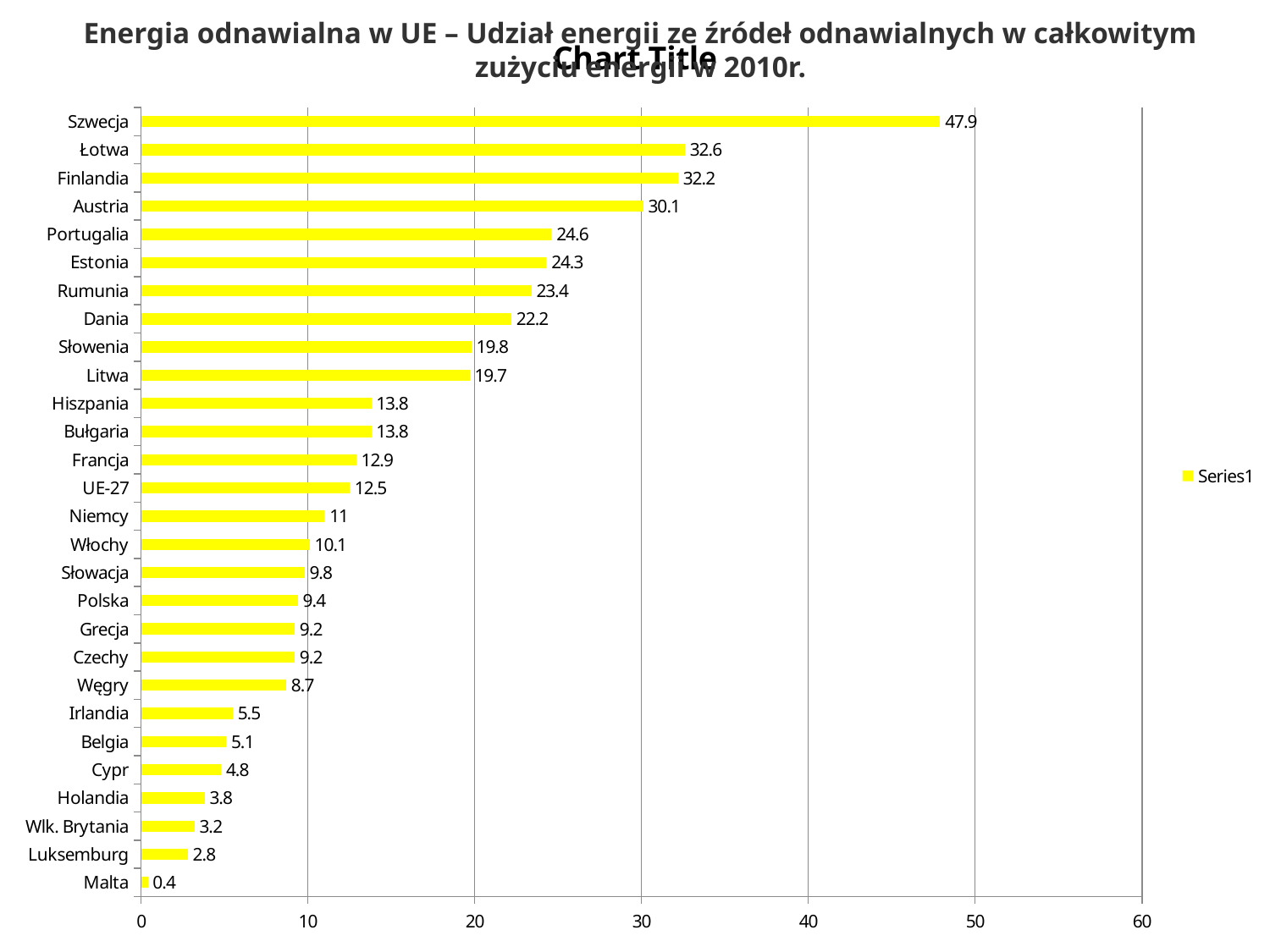
Which has a larger value, Portugalia or Dania? Portugalia What is the difference between the values for Szwecja and Łotwa? 15.3 Is the value for Finlandia greater or less than 30? greater What kind of chart is shown on the slide? bar chart Which country has the highest value? Szwecja What is the value for Austria? 30.1 What is the difference between the values for Polska and Niemcy? 1.6 What is the value for UE-27? 12.5 How many categories are shown on the chart? 28 What is the value for Polska? 9.4 What is the legend entry shown on the chart? Series1 Which country has the lowest value? Malta